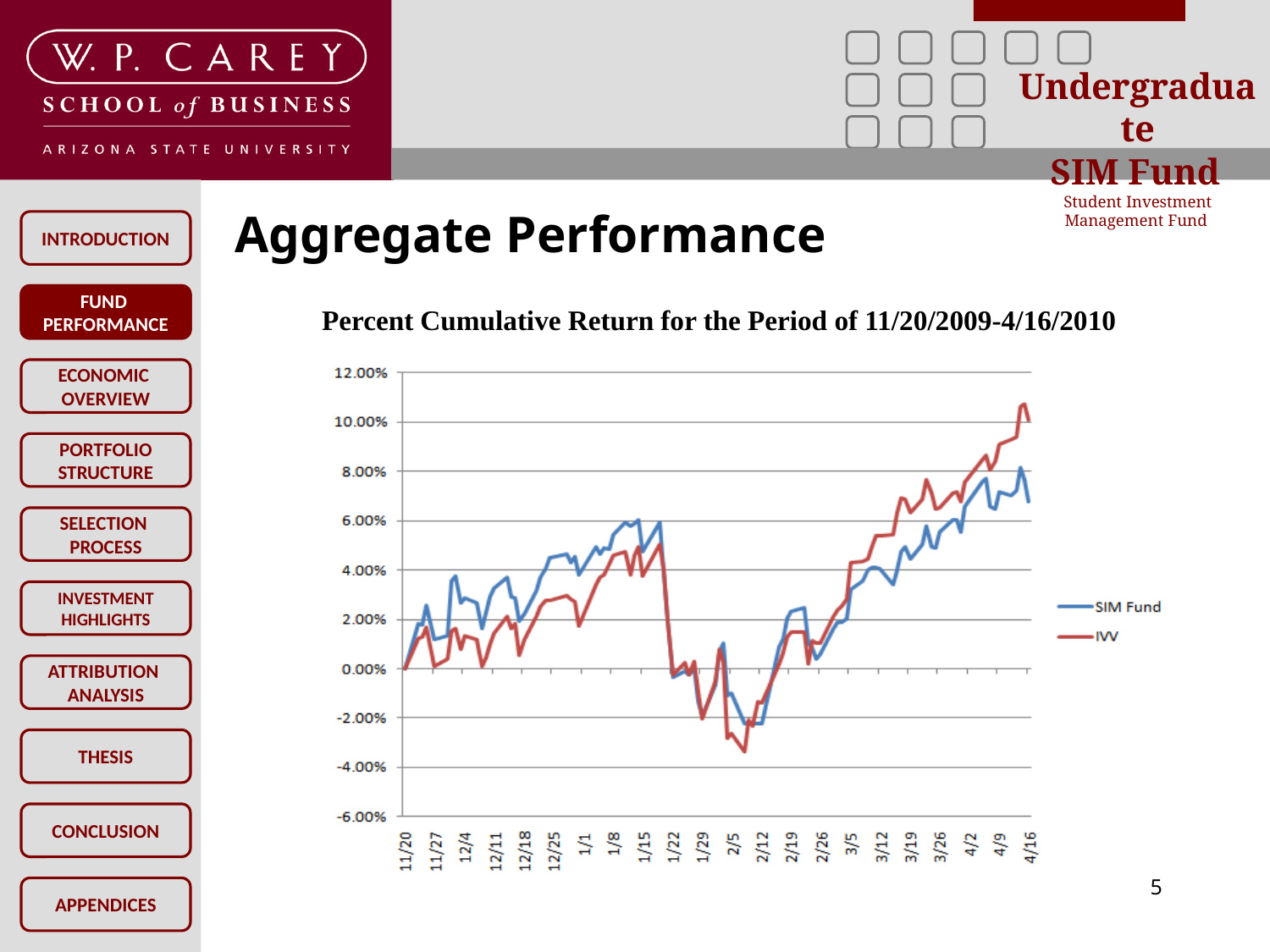
How many date labels are shown along the x axis? 22 What kind of chart is shown on the slide? line chart Which colour is used for the SIM Fund line? blue At 4/16, which series has the higher cumulative return, SIM Fund or IVV? IVV Is the value for SIM Fund at 4/16 greater or less than 8.00%? less How many series does the legend list? 2 Overall, do the cumulative returns rise or fall from 11/20 to 4/16? rise Around 1/8, which series has the higher cumulative return, SIM Fund or IVV? SIM Fund What is the title of the chart? Percent Cumulative Return for the Period of 11/20/2009-4/16/2010 Which series reaches the lowest cumulative return during the period? IVV What is the cumulative return of the SIM Fund at 11/20, the start of the period? 0.00% Is the value for IVV at 4/9 greater or less than 8.00%? greater